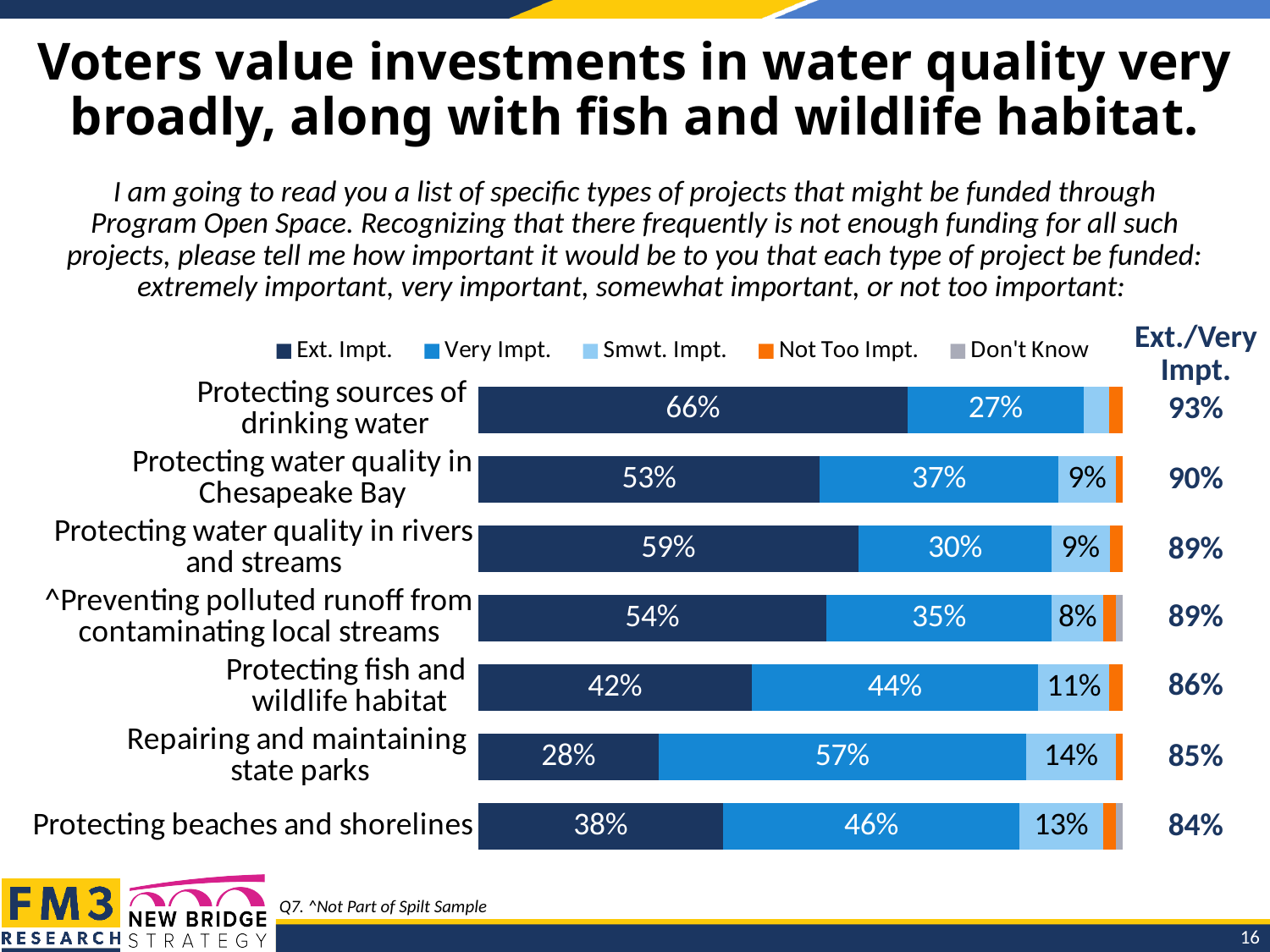
Which project type has the highest Very Impt. percentage? Repairing and maintaining state parks What is the difference in Ext. Impt. percentage between "Protecting sources of drinking water" and "Protecting water quality in Chesapeake Bay"? 13 percentage points Which project type has the highest Ext. Impt. percentage? Protecting sources of drinking water What percentage of voters rated "Repairing and maintaining state parks" as Very Impt.? 57% Which project type has the lowest Ext. Impt. percentage? Repairing and maintaining state parks How many series does the legend list? 5 Which has a larger Very Impt. percentage: "Protecting fish and wildlife habitat" or "Protecting beaches and shorelines"? Protecting beaches and shorelines What percentage of voters rated "Protecting sources of drinking water" as Ext. Impt.? 66% How many project types are shown in the chart? 7 What kind of chart is shown on the slide? Stacked bar chart What is the combined Ext./Very Impt. percentage for "Protecting fish and wildlife habitat"? 86% What is the Smwt. Impt. value for "Protecting beaches and shorelines"? 13%